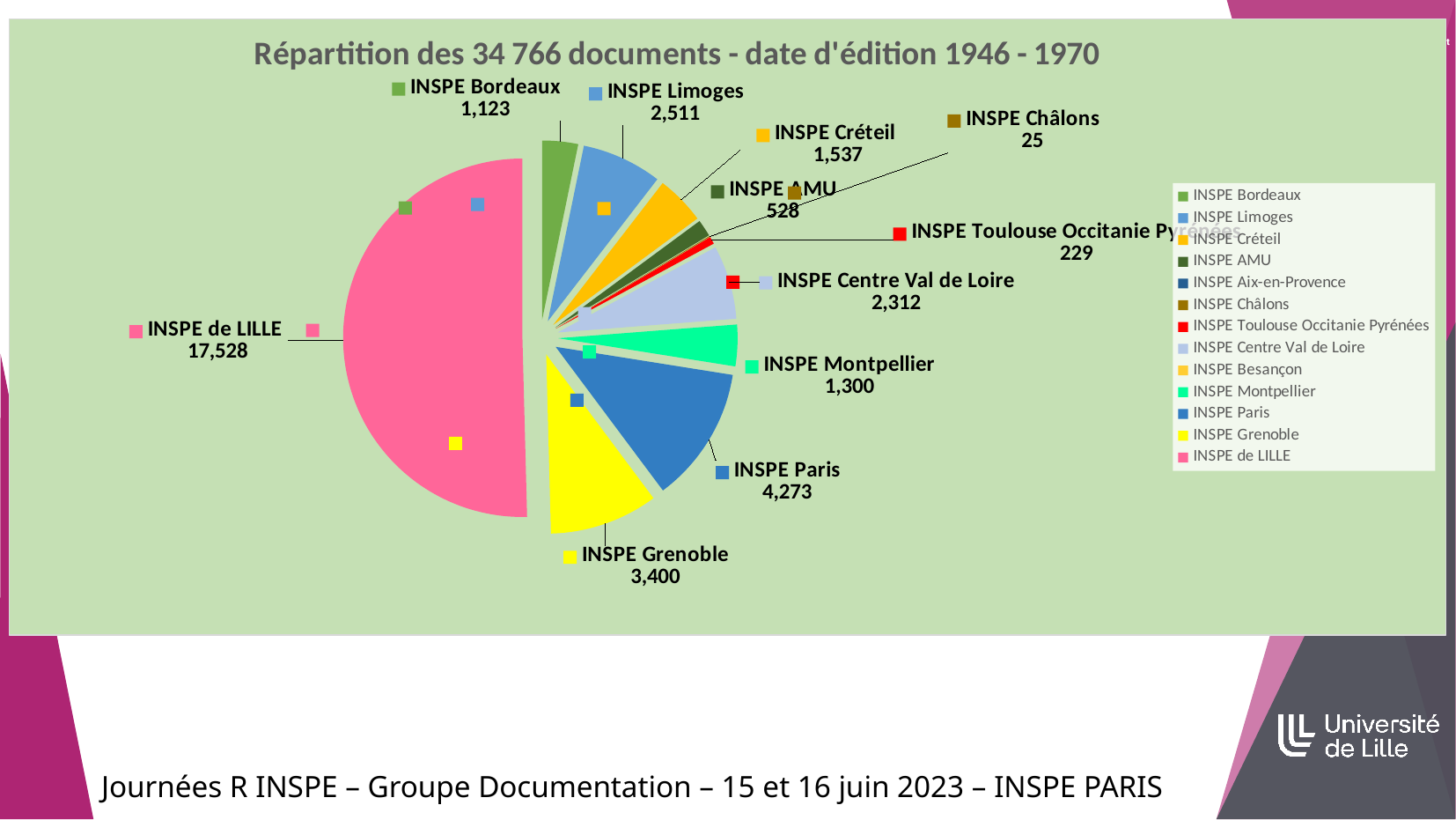
What is the difference between the values for INSPE Paris and INSPE Grenoble? 873 What is the value for INSPE Paris? 4,273 What is the difference between the values for INSPE de LILLE and INSPE Paris? 13,255 Which is larger, the value for INSPE Limoges or INSPE Créteil? INSPE Limoges What type of chart is shown on the slide? pie chart What colour is the INSPE Grenoble slice? yellow What is the value for INSPE Centre Val de Loire? 2,312 What is the value for INSPE de LILLE? 17,528 What is the value for INSPE Châlons? 25 How many categories does the chart legend list? 13 What is the title of the chart? Répartition des 34 766 documents - date d'édition 1946 - 1970 Which category has the largest slice of the pie? INSPE de LILLE